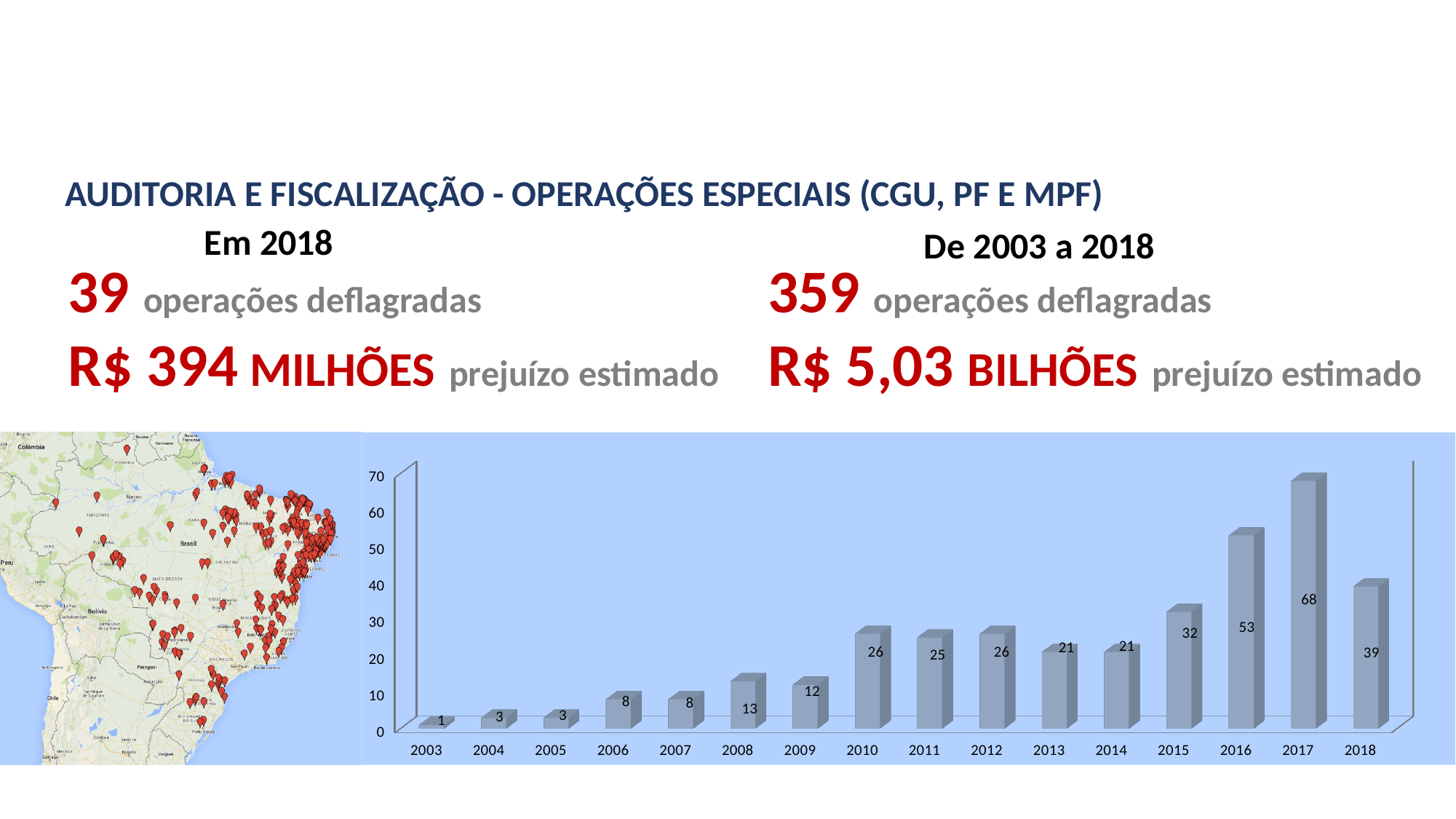
What value is shown for 2017 in the bar chart? 68 Is the value for 2016 in the bar chart greater or less than 40? greater How many years are shown on the x axis of the bar chart? 16 What kind of chart is shown on the slide? bar chart What is the difference between the values for 2016 and 2015 in the bar chart? 21 Do the values in the bar chart generally rise or fall from 2003 to 2017? rise What value is shown for 2003 in the bar chart? 1 Which is larger in the bar chart, the value for 2008 or the value for 2009? 2008 Which year has the lowest value in the bar chart? 2003 What value is shown for 2010 in the bar chart? 26 Which year has the highest value in the bar chart? 2017 What is the difference between the values for 2017 and 2018 in the bar chart? 29